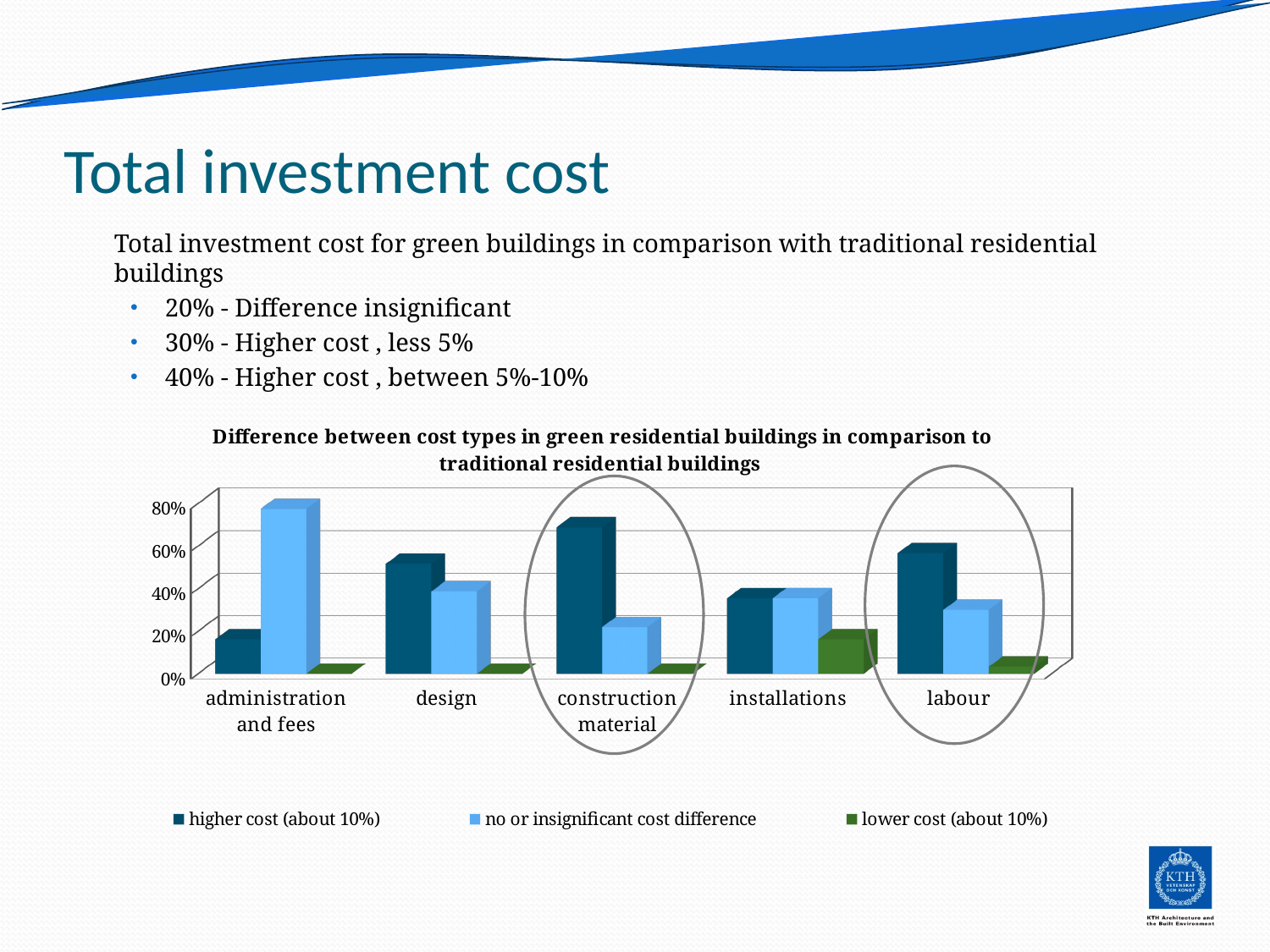
For design, which is larger: the 'higher cost (about 10%)' bar or the 'no or insignificant cost difference' bar? higher cost (about 10%) What kind of chart is shown on the slide? bar chart Is the 'no or insignificant cost difference' value for administration and fees greater or less than 60%? greater Is the 'no or insignificant cost difference' value for construction material greater or less than 40%? less How many series does the chart's legend list? 3 Which category has the tallest 'lower cost (about 10%)' bar? installations Which category has the highest bar for 'higher cost (about 10%)'? construction material Which category has the lowest bar for 'higher cost (about 10%)'? administration and fees What is the title of the chart? Difference between cost types in green residential buildings in comparison to traditional residential buildings Is the 'higher cost (about 10%)' value for construction material greater or less than 60%? greater Which category has the highest bar for 'no or insignificant cost difference'? administration and fees How many categories are shown on the x axis of the chart? 5